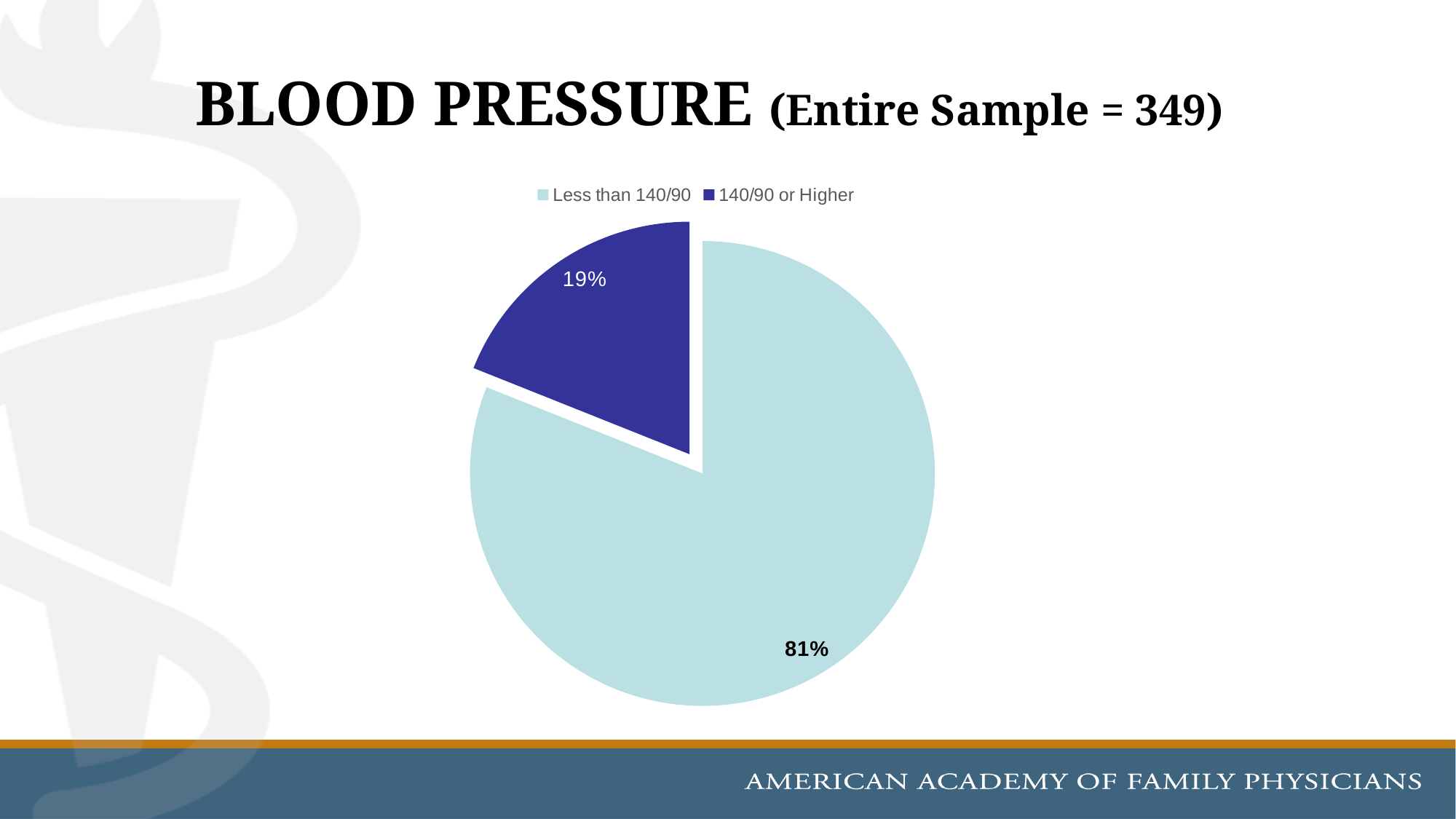
What is the difference in percentage points between the "Less than 140/90" slice and the "140/90 or Higher" slice? 62 Which slice is larger, "Less than 140/90" or "140/90 or Higher"? Less than 140/90 Which category has the smallest slice of the pie? 140/90 or Higher Which colour is used for the "140/90 or Higher" slice? dark blue How many entries does the legend list? 2 What is the size of the entire sample stated in the slide title? 349 What kind of chart is shown on the slide? pie chart What share of the pie is labelled "140/90 or Higher"? 19% Which category has the largest slice of the pie? Less than 140/90 How many slices does the pie chart have? 2 What share of the pie is labelled "Less than 140/90"? 81%